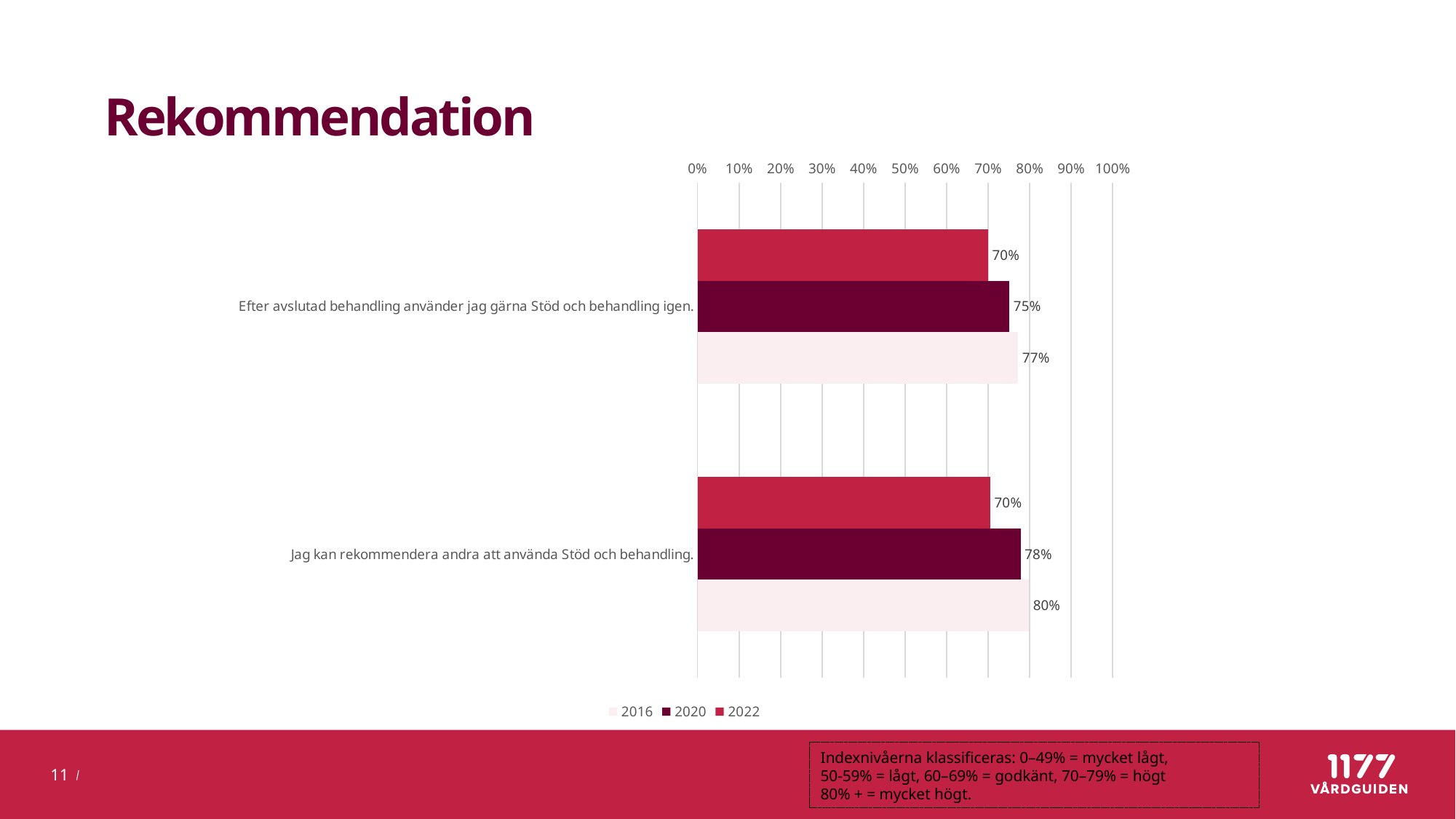
What is the 2022 value for "Jag kan rekommendera andra att använda Stöd och behandling."? 70% What is the difference between the 2020 and 2022 values for "Efter avslutad behandling använder jag gärna Stöd och behandling igen."? 5% What is the difference between the 2016 and 2022 values for "Jag kan rekommendera andra att använda Stöd och behandling."? 10% How many categories (statements) are shown on the chart? 2 What is the 2020 value for "Efter avslutad behandling använder jag gärna Stöd och behandling igen."? 75% How many series does the legend list? 3 Which year has the lowest value for "Efter avslutad behandling använder jag gärna Stöd och behandling igen."? 2022 What kind of chart is shown on the slide? Bar chart What is the 2016 value for "Efter avslutad behandling använder jag gärna Stöd och behandling igen."? 77% Which year has the highest value for "Jag kan rekommendera andra att använda Stöd och behandling."? 2016 What is the 2016 value for "Jag kan rekommendera andra att använda Stöd och behandling."? 80% Which is larger: the 2020 value for "Jag kan rekommendera andra att använda Stöd och behandling." or the 2020 value for "Efter avslutad behandling använder jag gärna Stöd och behandling igen."? Jag kan rekommendera andra att använda Stöd och behandling.